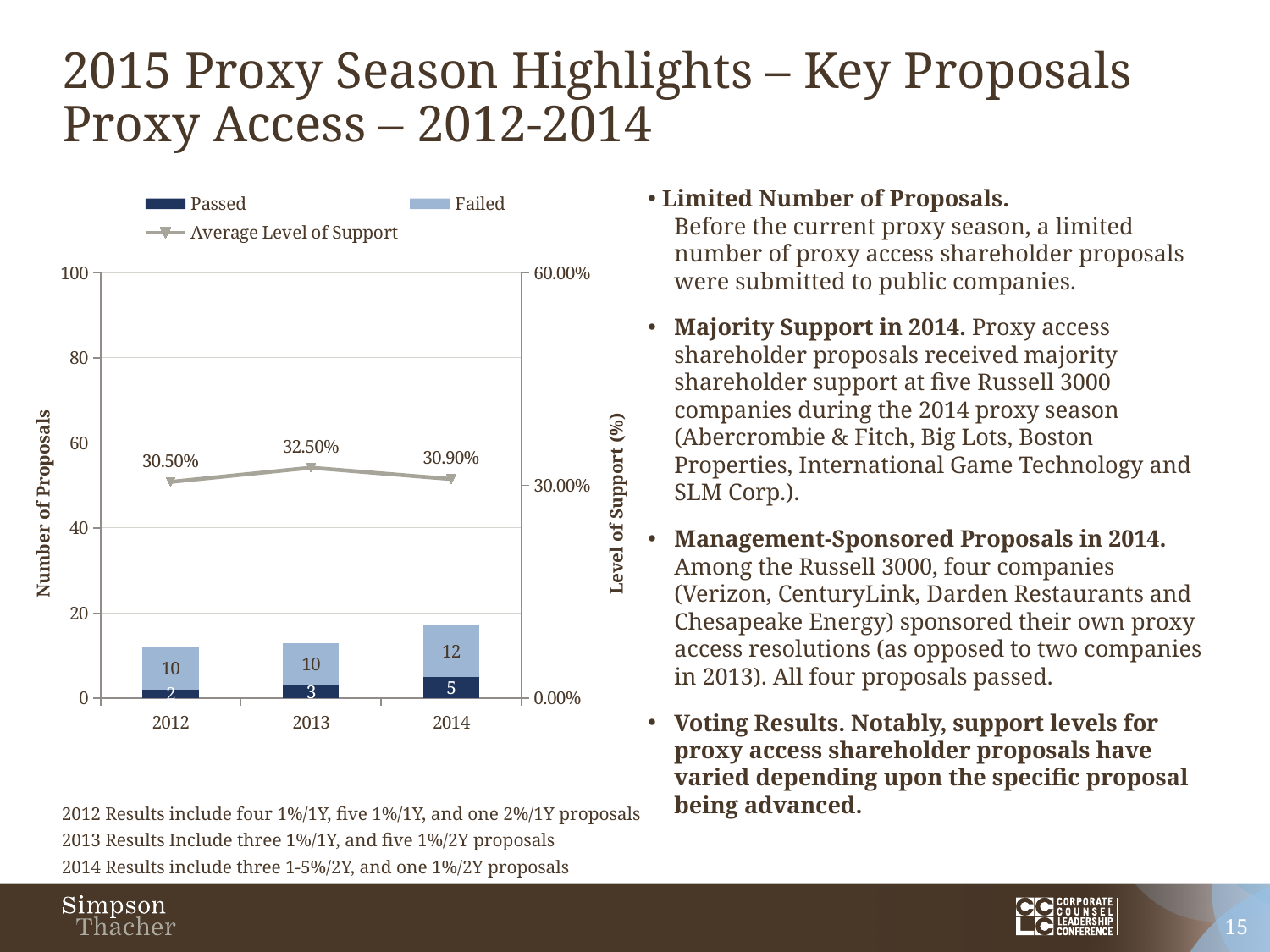
How many Passed proposals are shown for 2014? 5 What is the Average Level of Support for 2013? 32.50% Which is larger, the number of Passed proposals in 2013 or in 2014? 2014 How many years are shown on the x axis? 3 What is the difference between the number of Failed proposals in 2014 and in 2013? 2 What kind of chart is this? Stacked bar chart with a line How many Failed proposals are shown for 2012? 10 What is the total number of proposals (Passed plus Failed) for 2014? 17 What is the label of the right-hand vertical axis? Level of Support (%) Which year has the lowest number of Passed proposals? 2012 How many series does the legend list? 3 Which year has the highest Average Level of Support? 2013